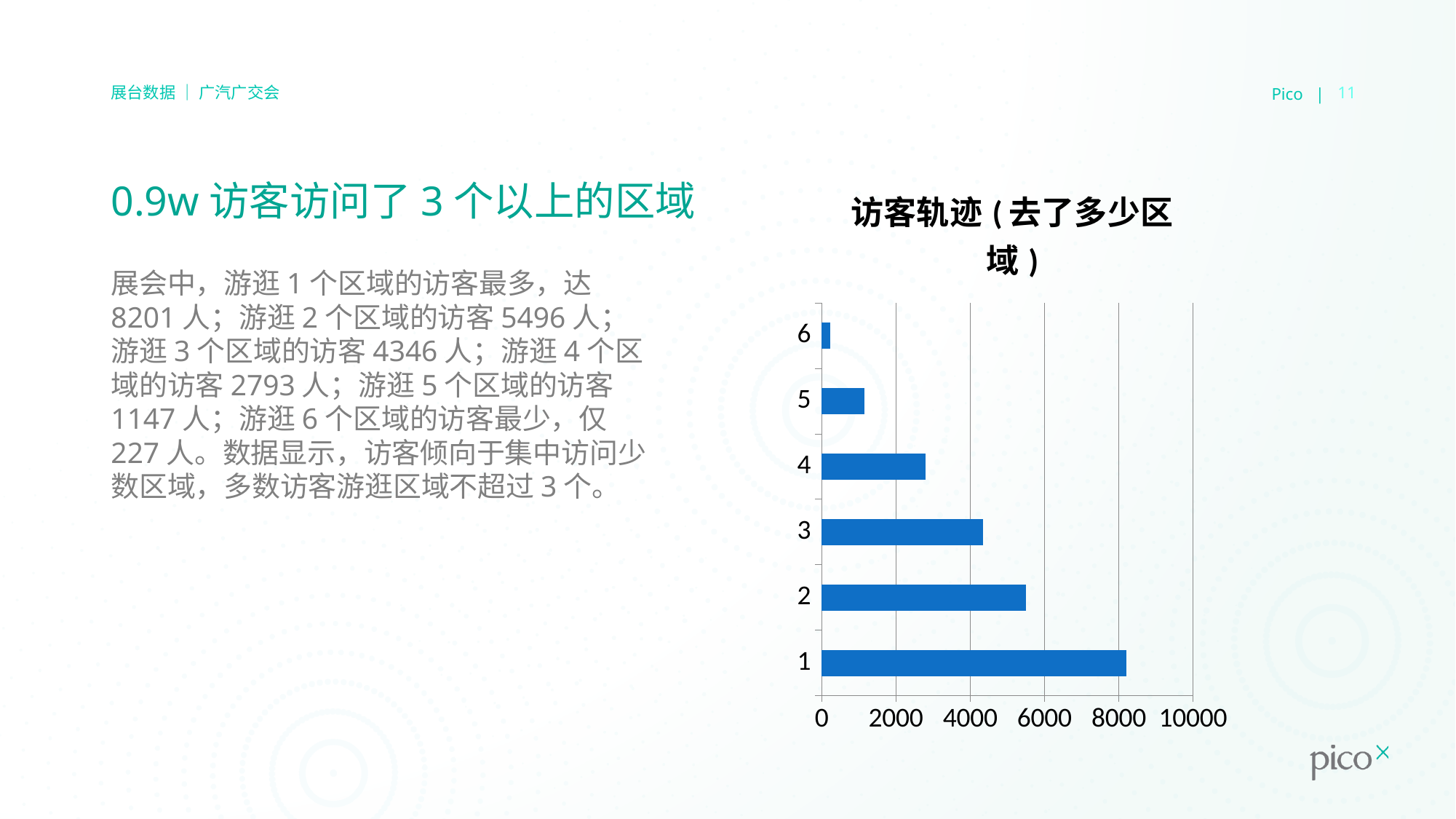
What is the title of the chart? 访客轨迹（去了多少区域） What is the difference between the number of visitors who visited 1 area and those who visited 2 areas? 2705 How many categories (bars) does the chart show? 6 Which is larger: the bar for 3 areas or the bar for 4 areas? 3 Which category has the lowest value in the chart? 6 Is the value for category 5 greater or less than 2000? less How many visitors visited 6 areas, according to the slide? 227 What kind of chart is shown on the slide? bar chart How many visitors visited 1 area, according to the slide? 8201 Is the value for category 2 greater or less than 4000? greater Do the bar values rise or fall as the number of areas visited increases from 1 to 6? fall Which category has the highest value in the chart? 1